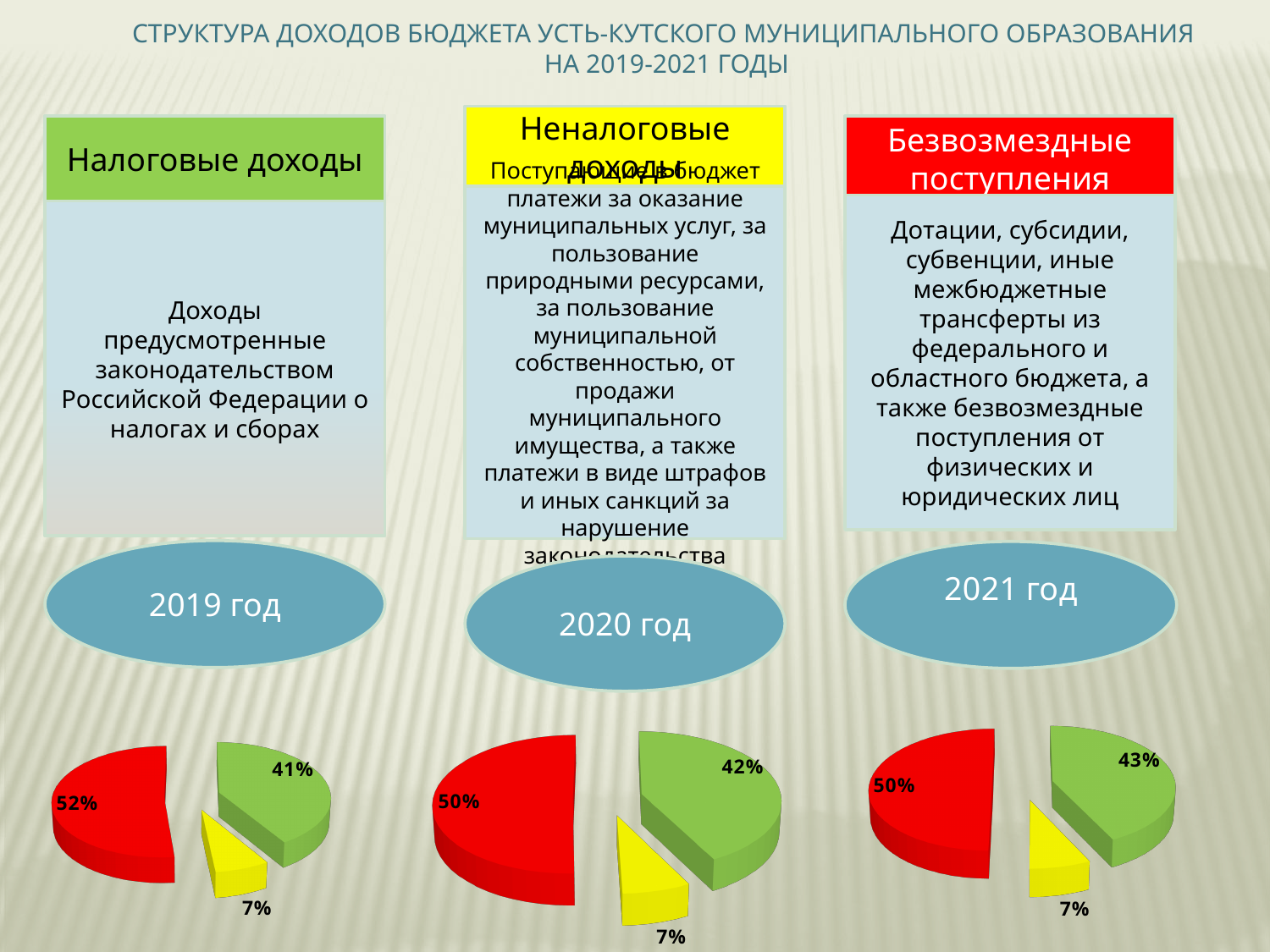
In the 2020 год pie chart, what share does the green slice (Налоговые доходы) have? 42% How many slices does each pie chart on the slide have? 3 What kind of chart is used for the 2019 год data? pie chart In the 2020 год pie chart, which slice is the smallest? the yellow slice (Неналоговые доходы), 7% How many pie charts are shown on the slide? 3 In the 2021 год pie chart, what share does the yellow slice (Неналоговые доходы) have? 7% In the 2019 год pie chart, what is the difference between the red slice (52%) and the green slice (41%)? 11 percentage points In the 2019 год pie chart, what share does the red slice (Безвозмездные поступления) have? 52% In the 2019 год pie chart, what share does the green slice (Налоговые доходы) have? 41% In the 2021 год pie chart, what share does the red slice (Безвозмездные поступления) have? 50% In the 2021 год pie chart, which is larger: the green slice or the red slice? the red slice (50%) In the 2019 год pie chart, which slice is the largest? the red slice (Безвозмездные поступления), 52%